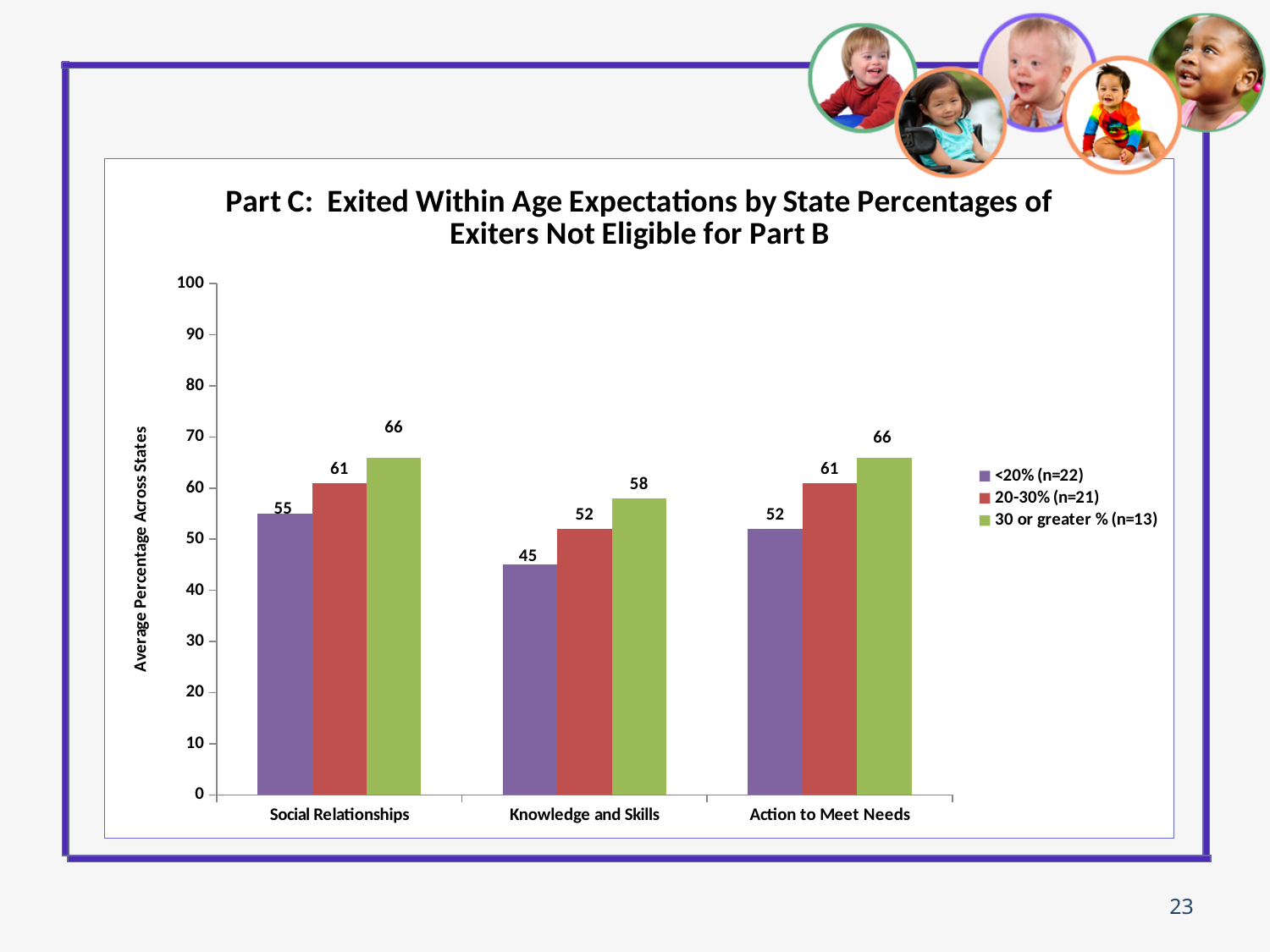
What kind of chart is shown on the slide? bar chart What is the value for the <20% (n=22) series in the Social Relationships category? 55 How many series does the legend list? 3 How many categories are shown on the x axis? 3 What is the label of the y axis? Average Percentage Across States Is the value for the 20-30% (n=21) series in Knowledge and Skills greater or less than 60? less What is the value for the 30 or greater % (n=13) series in the Knowledge and Skills category? 58 What is the difference between the 30 or greater % (n=13) and <20% (n=22) values in the Knowledge and Skills category? 13 Which series has the highest value in the Social Relationships category? 30 or greater % (n=13) Which is larger: the <20% (n=22) value for Social Relationships or the <20% (n=22) value for Action to Meet Needs? Social Relationships What is the value for the 20-30% (n=21) series in the Action to Meet Needs category? 61 Which category has the lowest value for the <20% (n=22) series? Knowledge and Skills